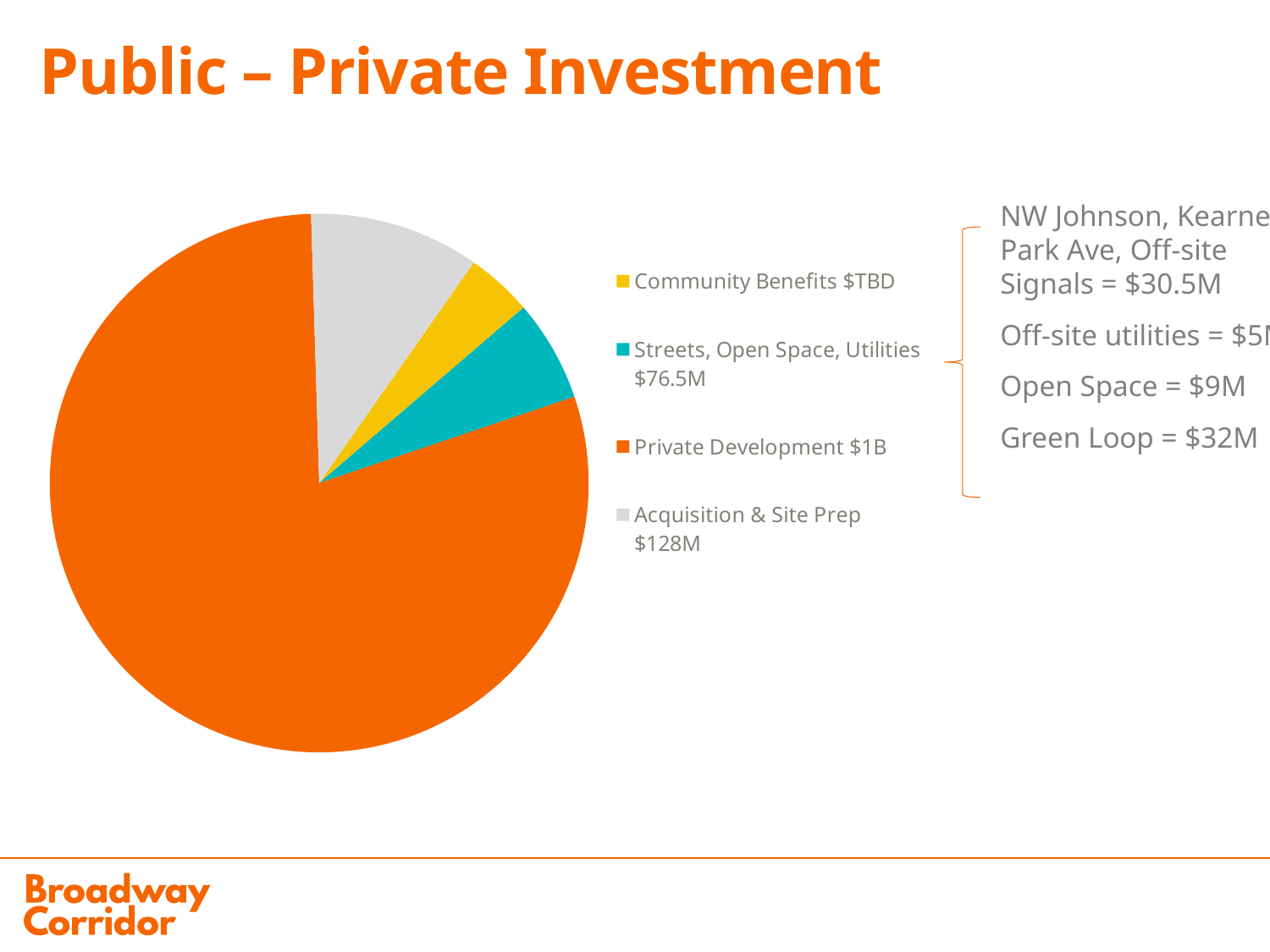
Which category has the smallest slice of the pie? Community Benefits $TBD What value is given for Private Development in the legend? $1B What kind of chart is shown on the slide? Pie chart How many slices does the pie chart have? 4 What is the difference between the Acquisition & Site Prep value and the Streets, Open Space, Utilities value? $51.5M What value is given for Acquisition & Site Prep in the legend? $128M Which category has the largest slice of the pie? Private Development $1B What colour is the Private Development slice? Orange How many entries does the legend list? 4 What value is given for Streets, Open Space, Utilities in the legend? $76.5M What value is given for Community Benefits in the legend? $TBD Which slice is larger: Acquisition & Site Prep or Streets, Open Space, Utilities? Acquisition & Site Prep